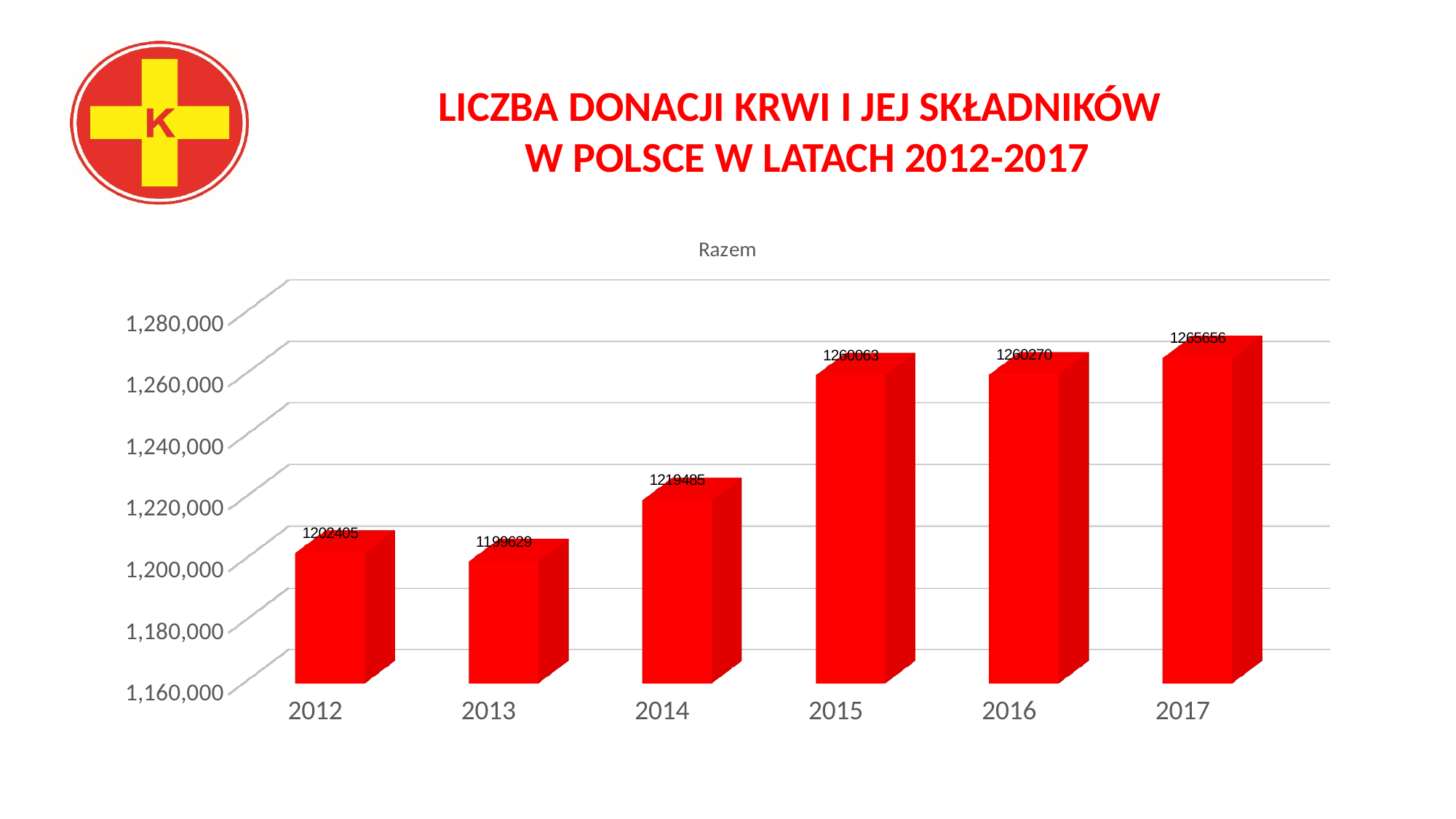
Which year has the highest value? 2017 Is the value for 2014 greater or less than 1,200,000? greater Which year has the lowest value? 2013 What kind of chart is shown on the slide? bar chart Which is larger, the value for 2014 or the value for 2015? 2015 What is the value for 2017? 1265656 What is the title of the chart? Razem How many years are shown on the x axis? 6 What is the difference between the values for 2014 and 2013? 19856 What is the value for 2015? 1260063 What is the difference between the values for 2017 and 2012? 63251 What is the value for 2012? 1202405